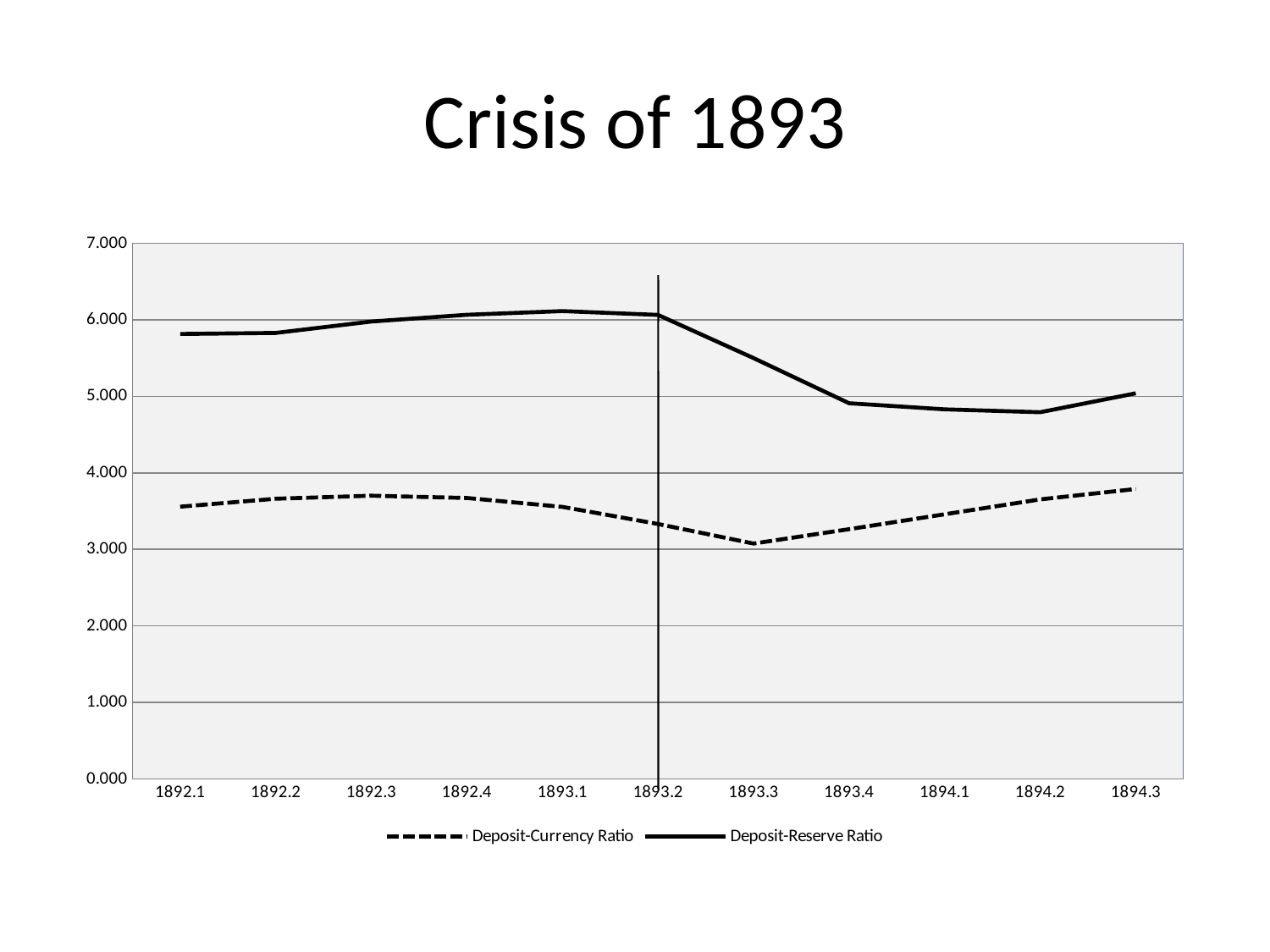
Which is larger, the Deposit-Reserve Ratio at 1893.2 or at 1893.3? 1893.2 Is the Deposit-Currency Ratio at 1892.3 greater or less than 4.000? less What kind of chart is shown on the slide? line chart Does the Deposit-Currency Ratio rise or fall from 1893.3 to 1894.3? rise Which series is drawn with a dashed line? Deposit-Currency Ratio Is the Deposit-Reserve Ratio at 1893.1 greater or less than 6.000? greater How many time periods are shown on the x axis? 11 At which period is the Deposit-Currency Ratio lowest? 1893.3 Is the Deposit-Reserve Ratio at 1893.4 greater or less than 5.000? less How many series does the legend list? 2 Does the Deposit-Reserve Ratio rise or fall from 1893.2 to 1893.4? fall